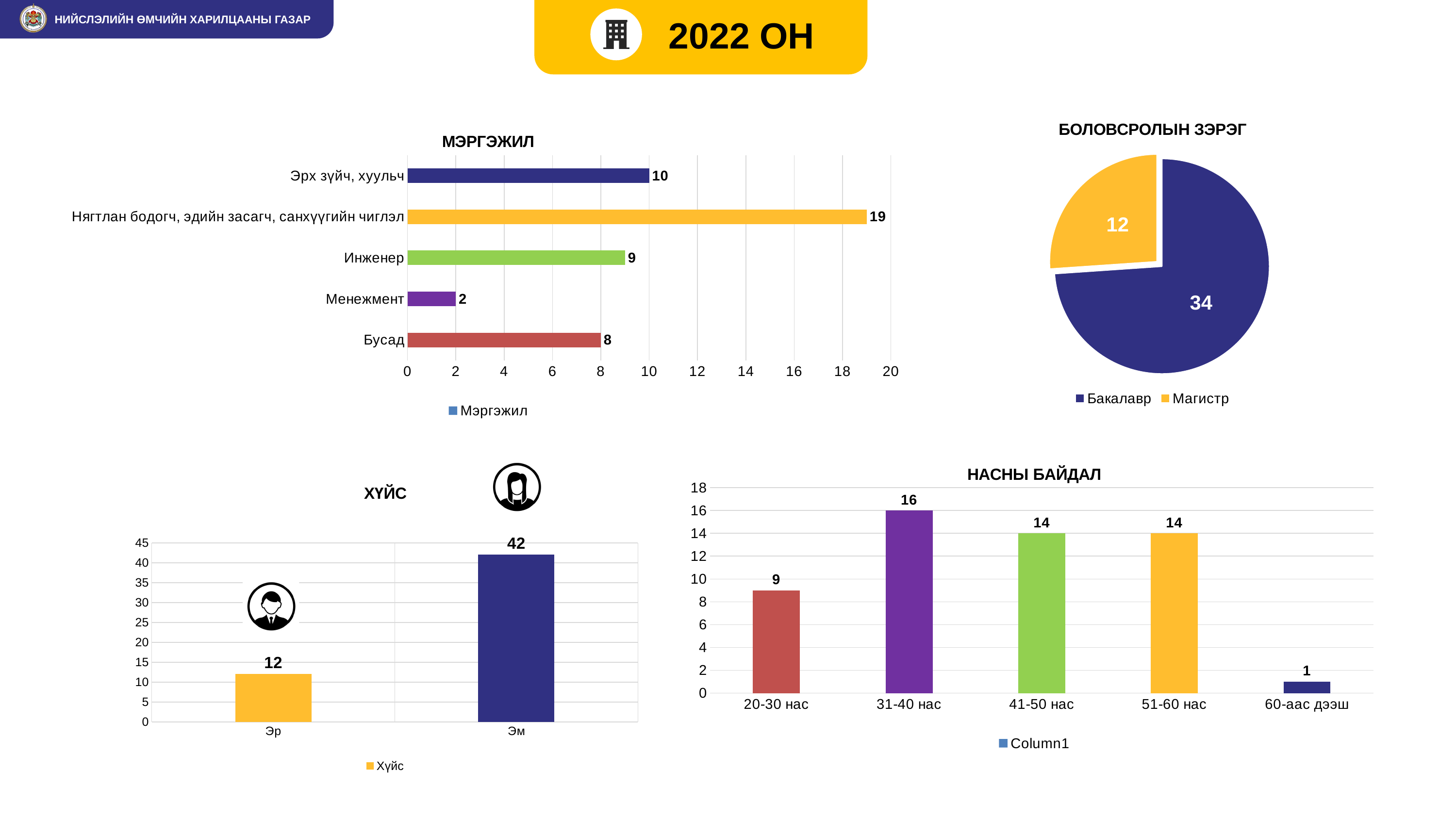
In the ХҮЙС chart, what is the difference between Эм and Эр? 30 In the МЭРГЭЖИЛ chart, which category has the lowest value? Менежмент In the МЭРГЭЖИЛ chart, which category has the highest value? Нягтлан бодогч, эдийн засагч, санхүүгийн чиглэл In the МЭРГЭЖИЛ chart, what is the value for Инженер? 9 In the НАСНЫ БАЙДАЛ chart, which category has the lowest value? 60-аас дээш In the БОЛОВСРОЛЫН ЗЭРЭГ chart, what is the value for Бакалавр? 34 What kind of chart is БОЛОВСРОЛЫН ЗЭРЭГ? pie chart How many categories does the МЭРГЭЖИЛ chart show? 5 In the БОЛОВСРОЛЫН ЗЭРЭГ chart, what is the total of the two slices? 46 In the ХҮЙС chart, which is larger, Эр or Эм? Эм In the МЭРГЭЖИЛ chart, what is the difference between Эрх зүйч, хуульч and Бусад? 2 In the НАСНЫ БАЙДАЛ chart, what is the value for 31-40 нас? 16